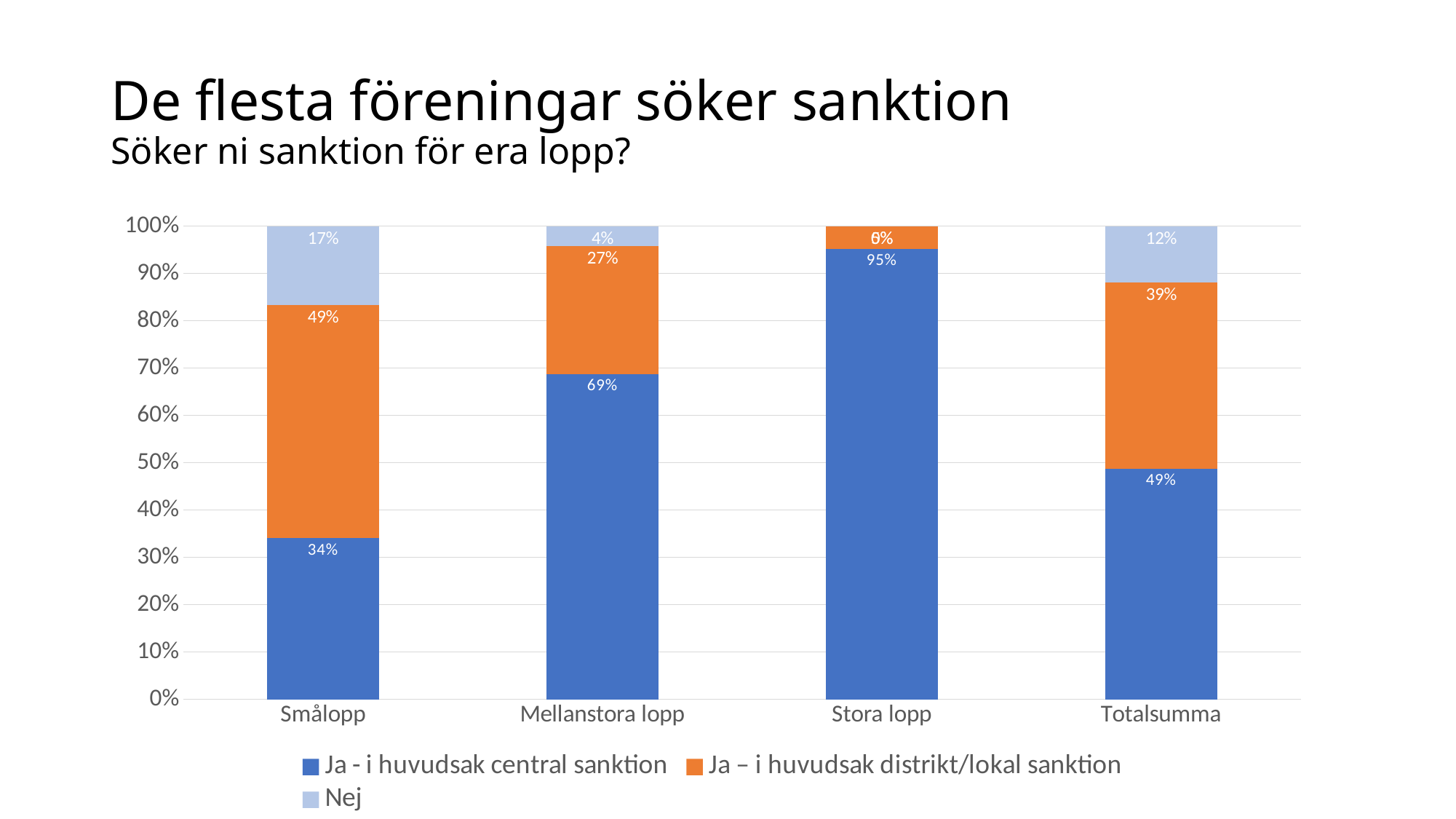
What is the value for 'Nej' for Totalsumma? 12% What is the chart's question shown as the subtitle on the slide? Söker ni sanktion för era lopp? Which category has the lowest value for 'Ja - i huvudsak central sanktion'? Smålopp Which category has the highest value for 'Ja - i huvudsak central sanktion'? Stora lopp What is the difference between the 'Nej' values for Smålopp and Mellanstora lopp? 13% What type of chart is shown on the slide? Stacked bar chart What is the value for 'Ja - i huvudsak central sanktion' for Smålopp? 34% What is the value for 'Ja - i huvudsak central sanktion' for Stora lopp? 95% How many categories are shown on the x axis? 4 How many series does the legend list? 3 Which is larger: the 'Ja – i huvudsak distrikt/lokal sanktion' value for Smålopp or for Totalsumma? Smålopp What is the value for 'Ja – i huvudsak distrikt/lokal sanktion' for Mellanstora lopp? 27%